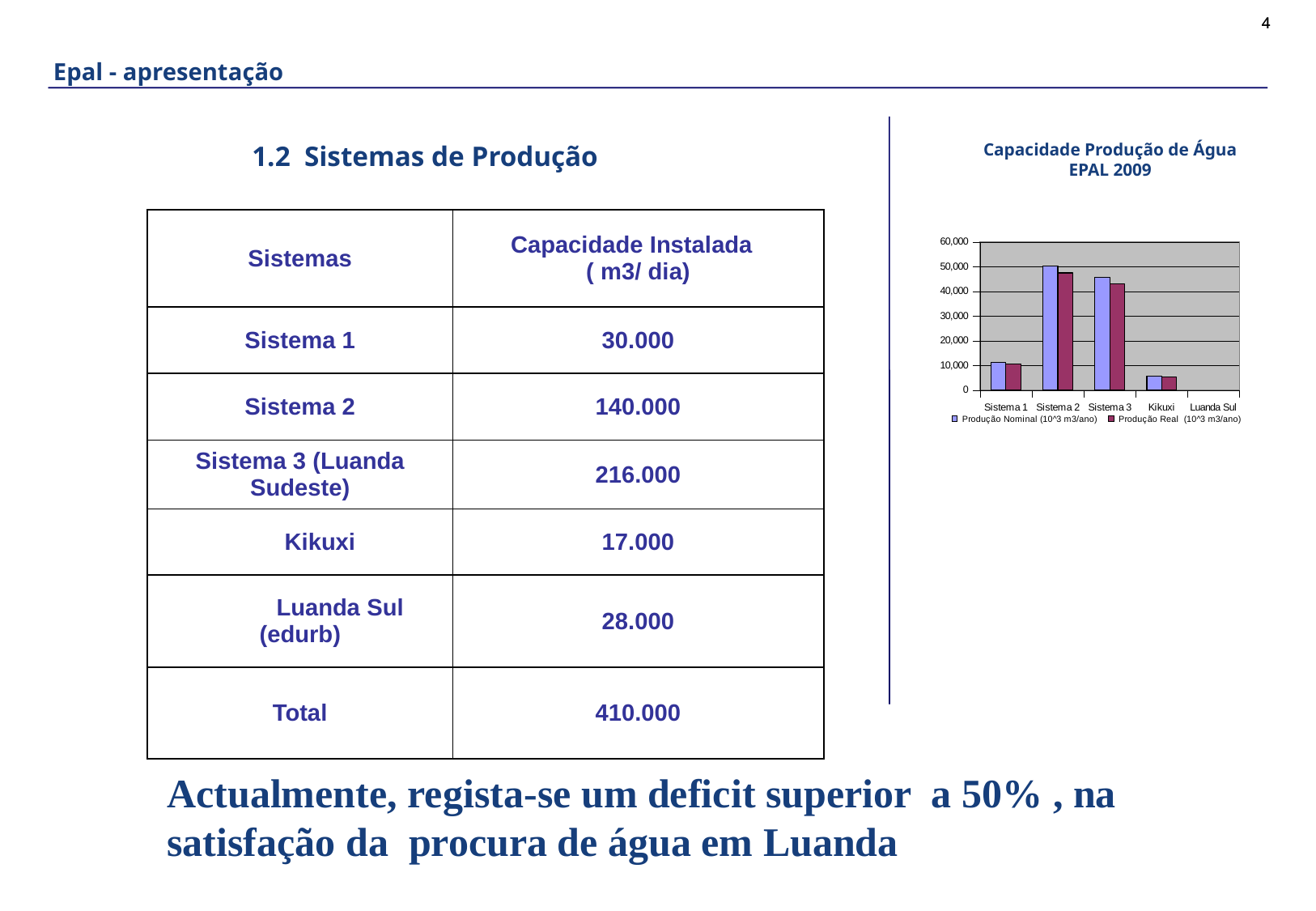
Which series is shown in purple/blue bars in the chart? Produção Nominal (10^3 m3/ano) Is the Produção Nominal value for Kikuxi greater or less than 10,000? less What is the title of the chart on the slide? Capacidade Produção de Água EPAL 2009 How many categories are shown on the x axis of the chart? 5 Which category has the highest Produção Nominal bar in the chart? Sistema 2 Is the Produção Real value for Sistema 3 greater or less than 50,000? less Is the Produção Nominal value for Sistema 1 greater or less than 20,000? less How many series does the chart's legend list? 2 Which is larger in the chart: the Produção Nominal bar for Sistema 2 or for Sistema 3? Sistema 2 Which category has the highest Produção Real bar in the chart? Sistema 2 What kind of chart is shown on the slide? bar chart